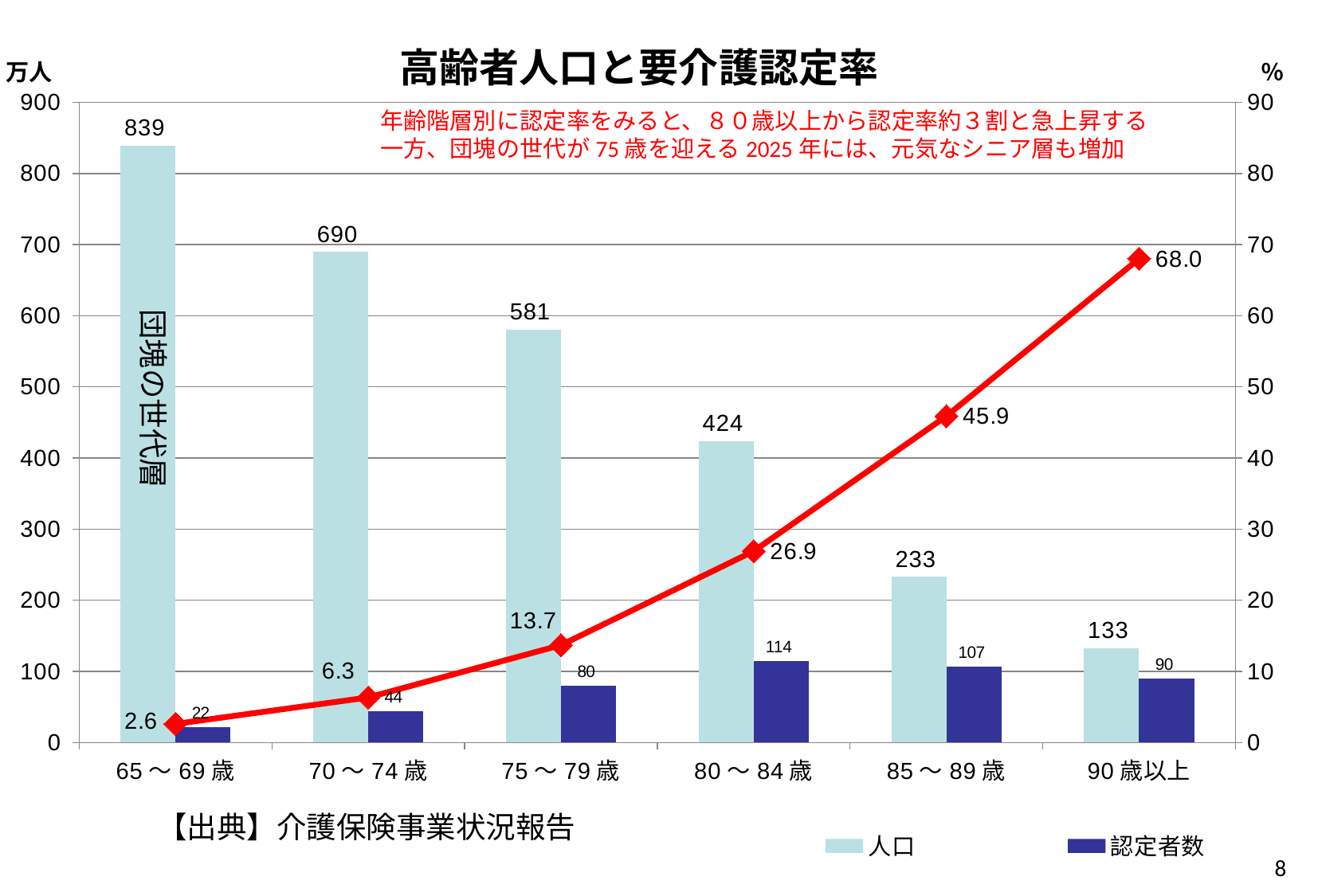
Does the red line rise or fall from 65～69歳 to 90歳以上? rise How many series does the legend list? 2 What colour are the 認定者数 bars? dark blue What is the 人口 value for 65～69歳? 839 What is the certification rate (red line) value for 90歳以上? 68.0 How many age groups are shown on the x axis? 6 Which is larger, the 認定者数 value for 85～89歳 or for 90歳以上? 85～89歳 What is the 認定者数 value for 80～84歳? 114 Which age group has the lowest 認定者数 value? 65～69歳 What is the difference between the 人口 values for 70～74歳 and 75～79歳? 109 Which age group has the highest 人口 value? 65～69歳 What is the title of the chart? 高齢者人口と要介護認定率